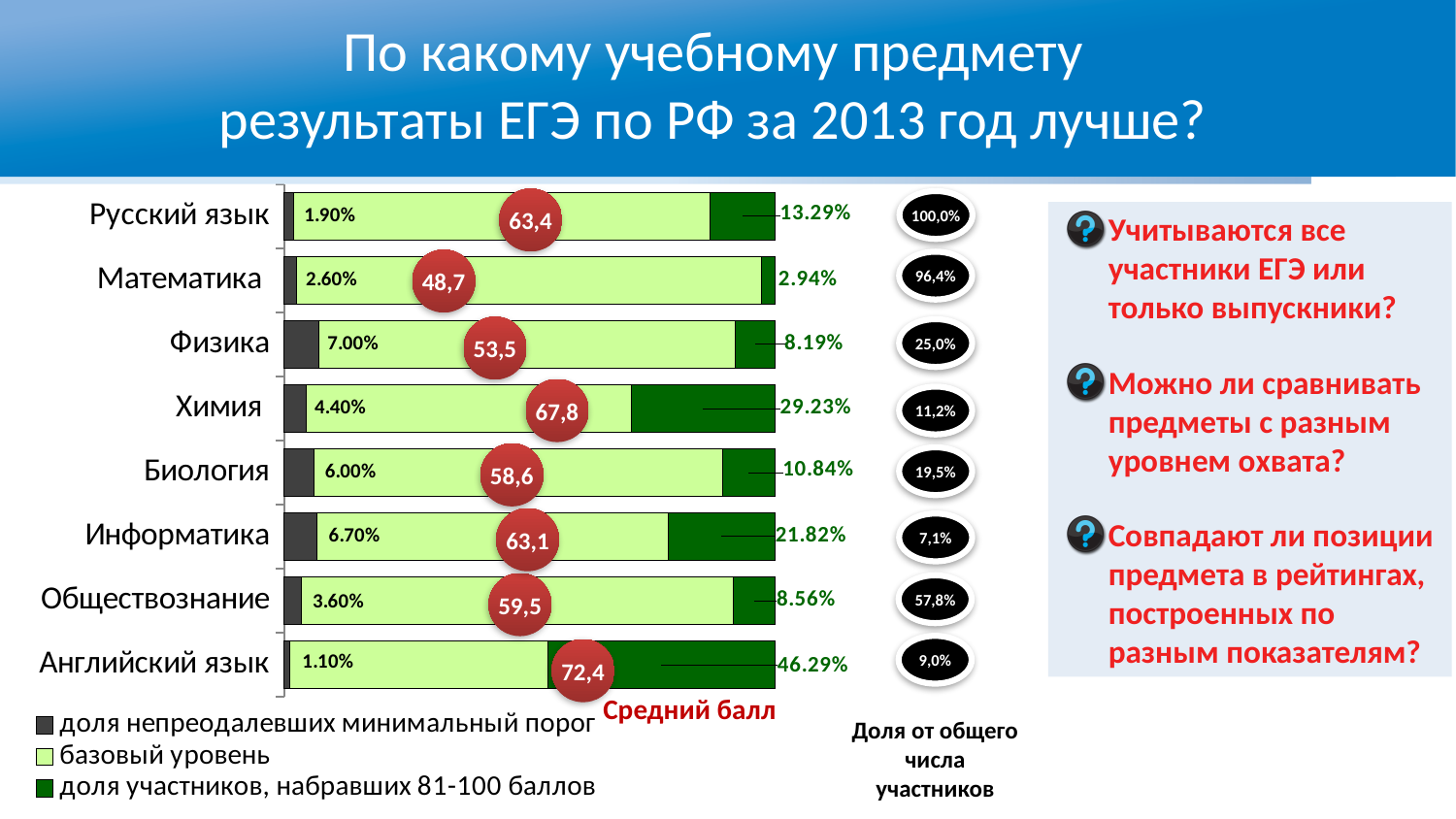
What is the share of participants who scored 81-100 points in Английский язык? 46.29% Which subject has a larger share of participants who did not pass the minimum threshold, Биология or Обществознание? Биология How many series does the chart legend list? 3 How many subjects (categories) are shown in the chart? 8 What is the share of participants who did not pass the minimum threshold in Физика? 7.00% What share of the total number of participants (Доля от общего числа участников) took Обществознание? 57,8% What kind of chart is shown on the slide? Stacked bar chart What is the difference between the share of participants scoring 81-100 points in Химия and in Информатика? 7.41% Which subject has the lowest average score? Математика Which subject has the highest share of participants scoring 81-100 points? Английский язык Which subject has the lowest share of participants scoring 81-100 points? Математика What is the average score (Средний балл) for Химия? 67,8